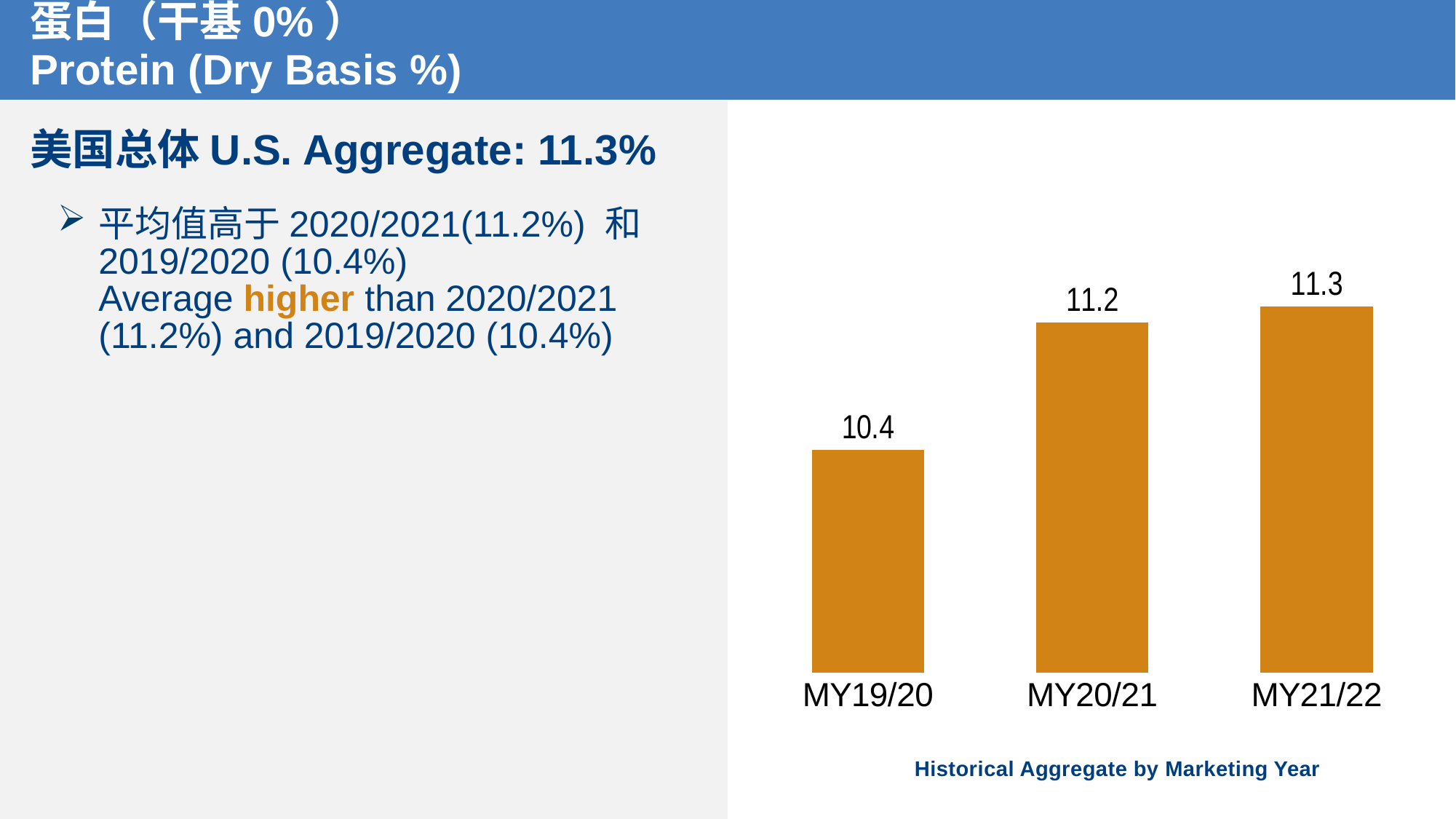
What is the value for MY20/21? 11.2 What is the difference between the values for MY21/22 and MY19/20? 0.9 Which marketing year has the lowest value? MY19/20 What is the caption below the chart? Historical Aggregate by Marketing Year What is the value for MY21/22? 11.3 What is the value for MY19/20? 10.4 What kind of chart is shown on the slide? Bar chart Which marketing year has the highest value? MY21/22 What is the difference between the values for MY20/21 and MY19/20? 0.8 How many marketing years are shown in the chart? 3 Do the values rise or fall from MY19/20 to MY21/22? Rise Which is larger, the value for MY19/20 or the value for MY20/21? MY20/21